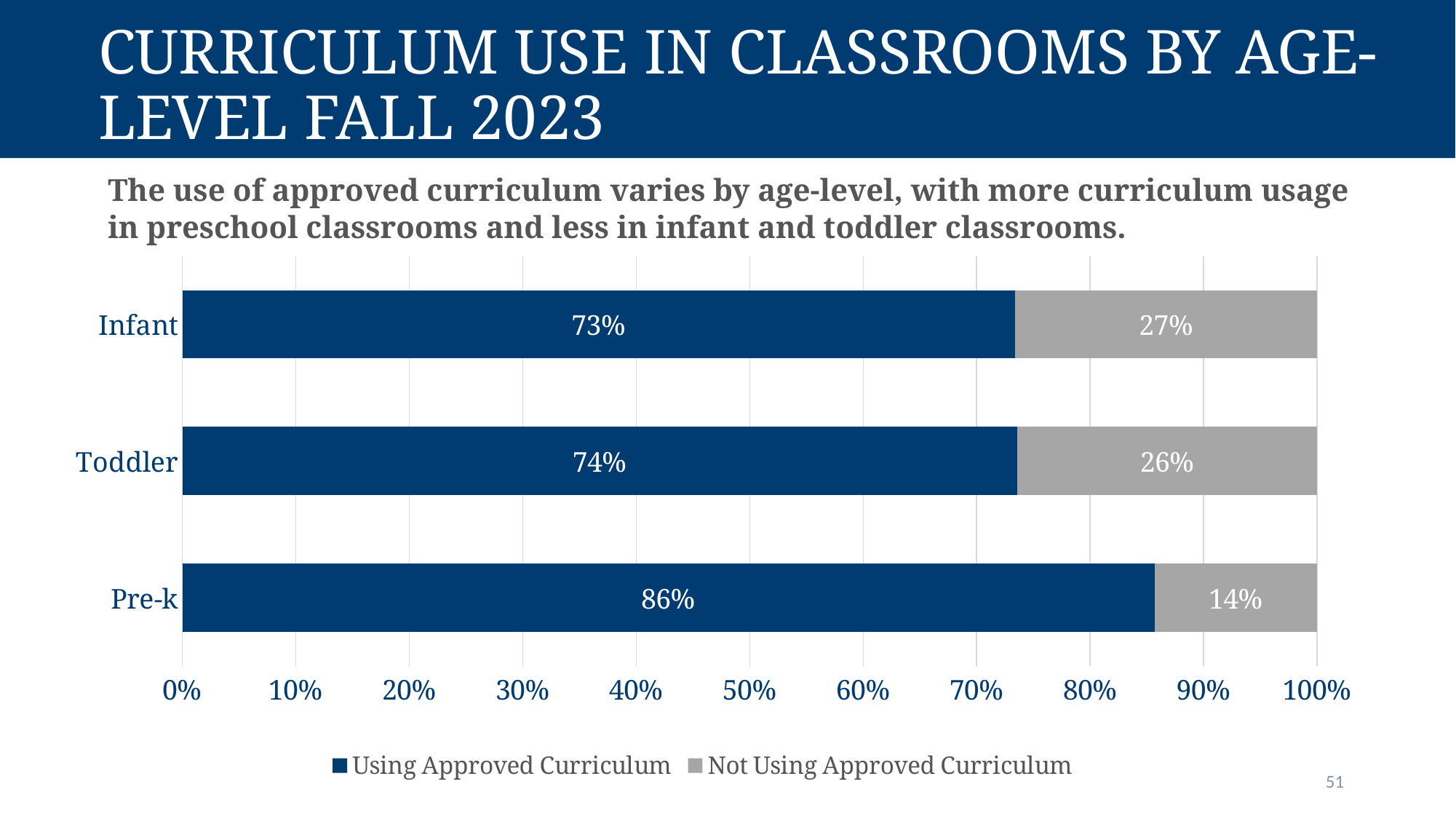
What kind of chart is shown on the slide? Stacked bar chart What percentage of Toddler classrooms are Not Using Approved Curriculum? 26% What percentage of Infant classrooms are Using Approved Curriculum? 73% How many series does the legend list? 2 What is the total of the stacked bar for Toddler? 100% Which age-level has the lowest share of classrooms Not Using Approved Curriculum? Pre-k Is the Using Approved Curriculum value for Toddler greater or less than 80%? less Which is larger: the Not Using Approved Curriculum share for Infant or for Pre-k? Infant What percentage of Pre-k classrooms are Using Approved Curriculum? 86% How many age-level categories are shown in the chart? 3 Which age-level has the highest share of classrooms Using Approved Curriculum? Pre-k What is the difference in percentage points between Pre-k and Infant classrooms Using Approved Curriculum? 13